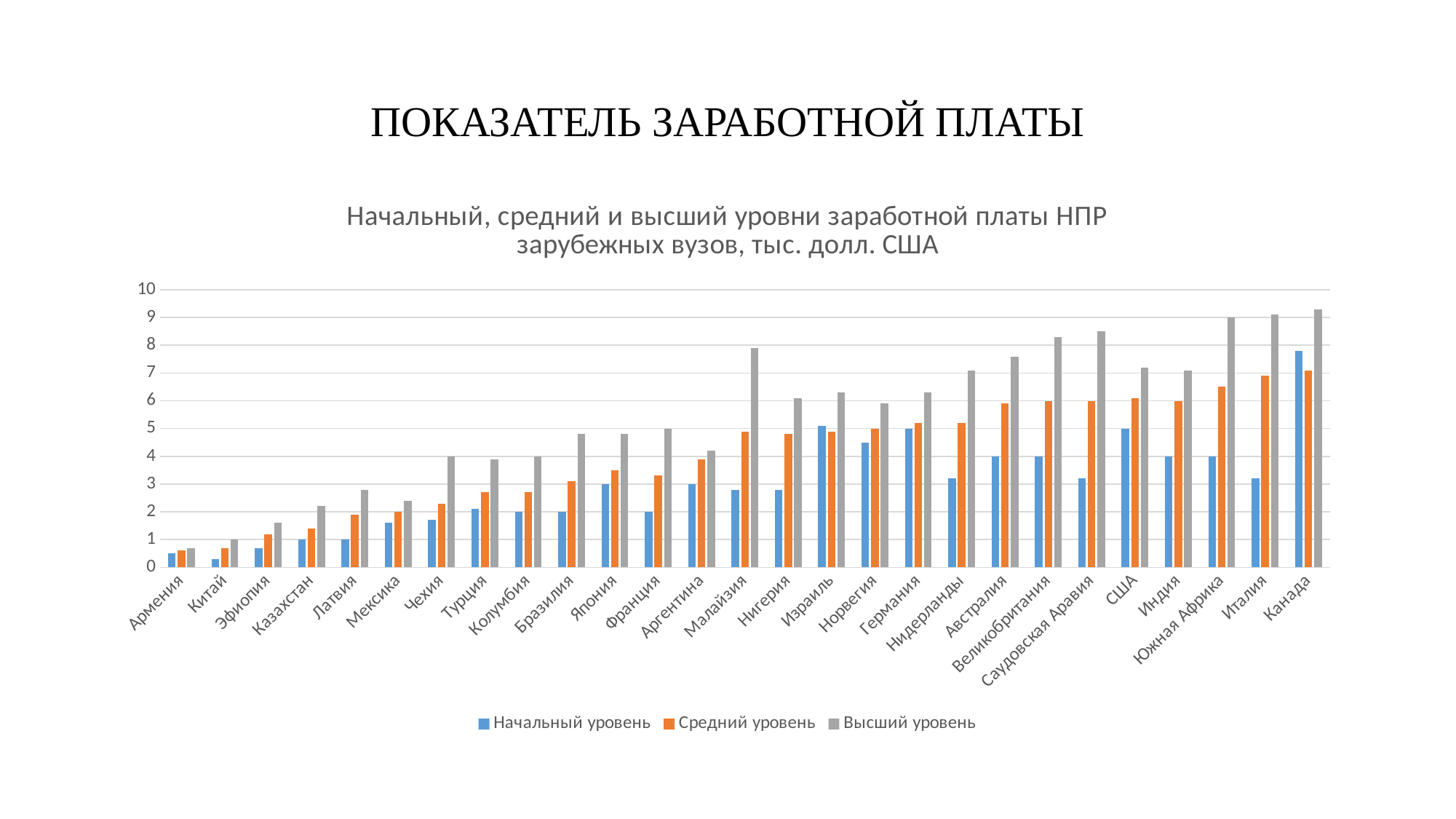
What is the value of Начальный уровень for Казахстан? 1 What kind of chart is shown on the slide? bar chart What is the value of Высший уровень for Южная Африка? 9 Do the Высший уровень values generally rise or fall from left to right along the x axis? rise What is the value of Средний уровень for Великобритания? 6 How many countries are shown on the x axis? 27 How many series does the legend list? 3 Is the value of Начальный уровень for Нигерия greater or less than 3? less Is the value of Высший уровень for Малайзия greater or less than 7? greater Which is larger: Высший уровень for Малайзия or Высший уровень for Нигерия? Малайзия Which country has the lowest value for Высший уровень? Армения Which country has the highest value for Начальный уровень? Канада